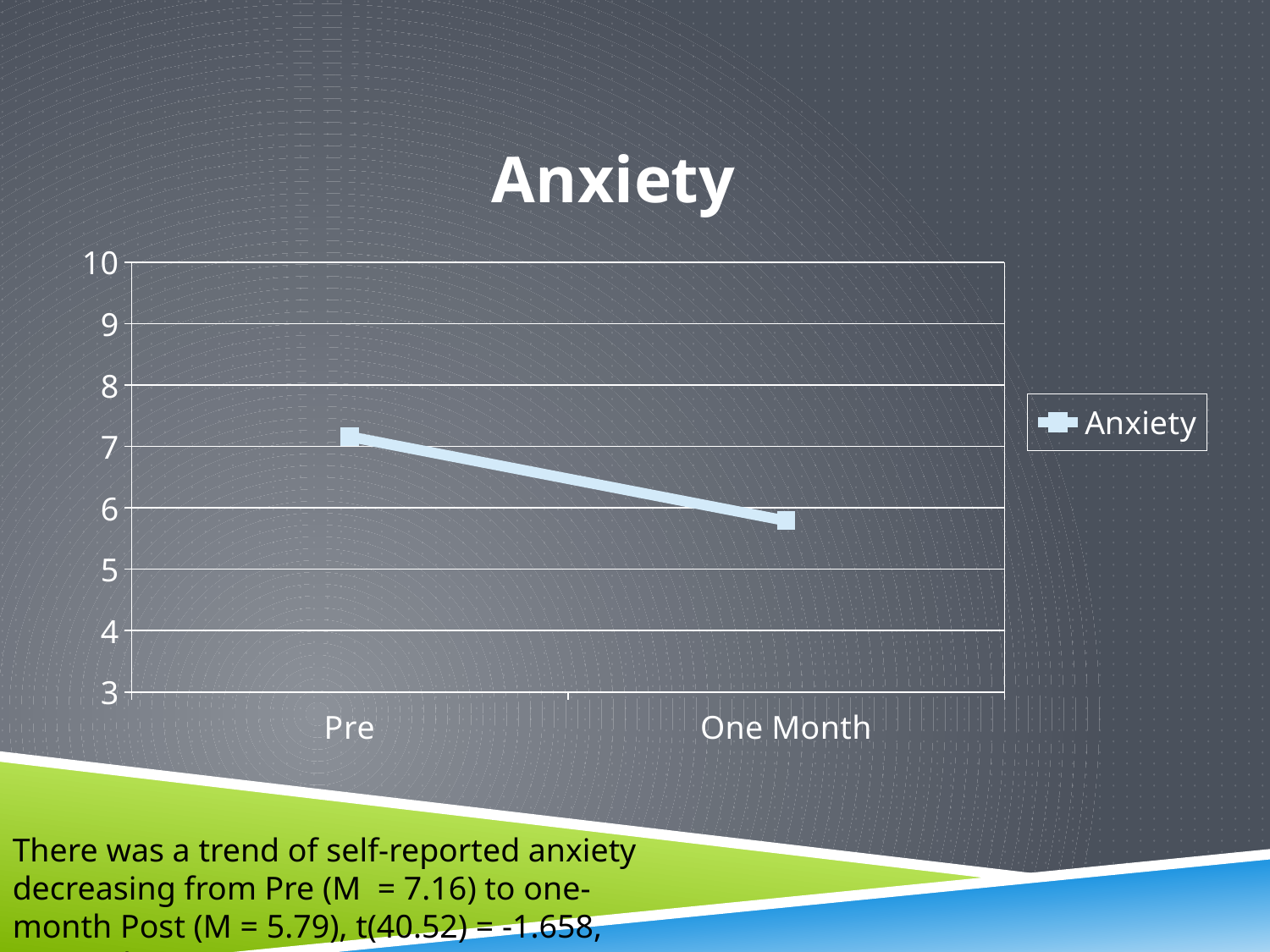
What is the name of the series shown in the legend? Anxiety According to the slide, what is the mean anxiety value at Pre? 7.16 What is the title of the chart? Anxiety What kind of chart is shown on the slide? Line chart How many series does the legend list? 1 Which time point has the higher anxiety value? Pre Is the anxiety value for Pre greater or less than 6? greater How many data points are plotted on the chart? 2 According to the slide, what is the mean anxiety value at one-month Post? 5.79 Which time point has the lower anxiety value? One Month Is the anxiety value for One Month greater or less than 7? less Does the anxiety value rise or fall from Pre to One Month? Fall